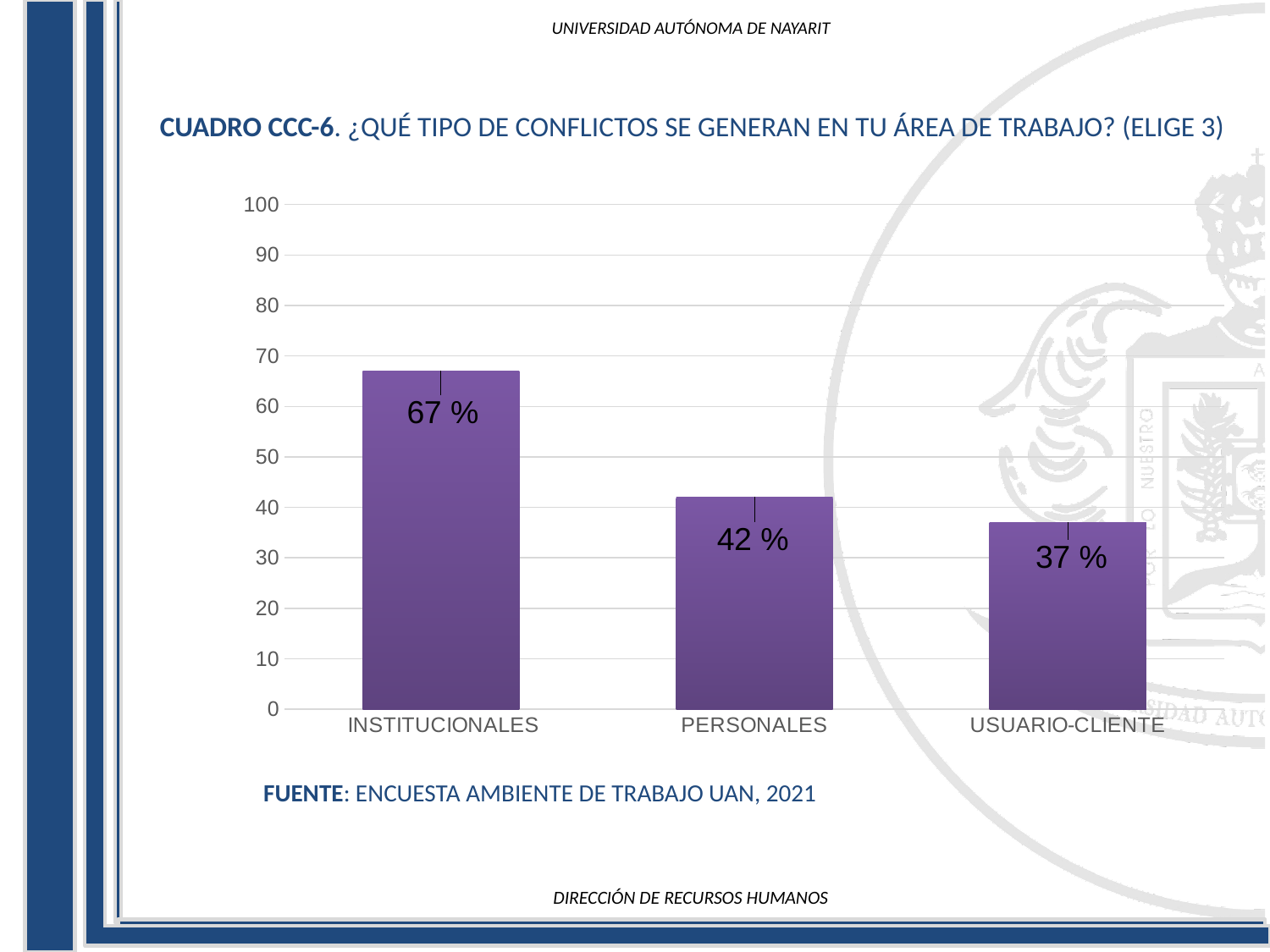
What is the value for USUARIO-CLIENTE? 37 % What is the difference between the values for INSTITUCIONALES and PERSONALES? 25 % Which is larger, the value for PERSONALES or the value for USUARIO-CLIENTE? PERSONALES Do the values rise or fall from left to right along the x axis? fall What is the value for INSTITUCIONALES? 67 % What is the value for PERSONALES? 42 % What kind of chart is shown on the slide? bar chart Is the value for INSTITUCIONALES greater or less than 60? greater What is the difference between the values for PERSONALES and USUARIO-CLIENTE? 5 % Which category has the lowest value? USUARIO-CLIENTE How many categories are shown on the x axis? 3 Which category has the highest value? INSTITUCIONALES